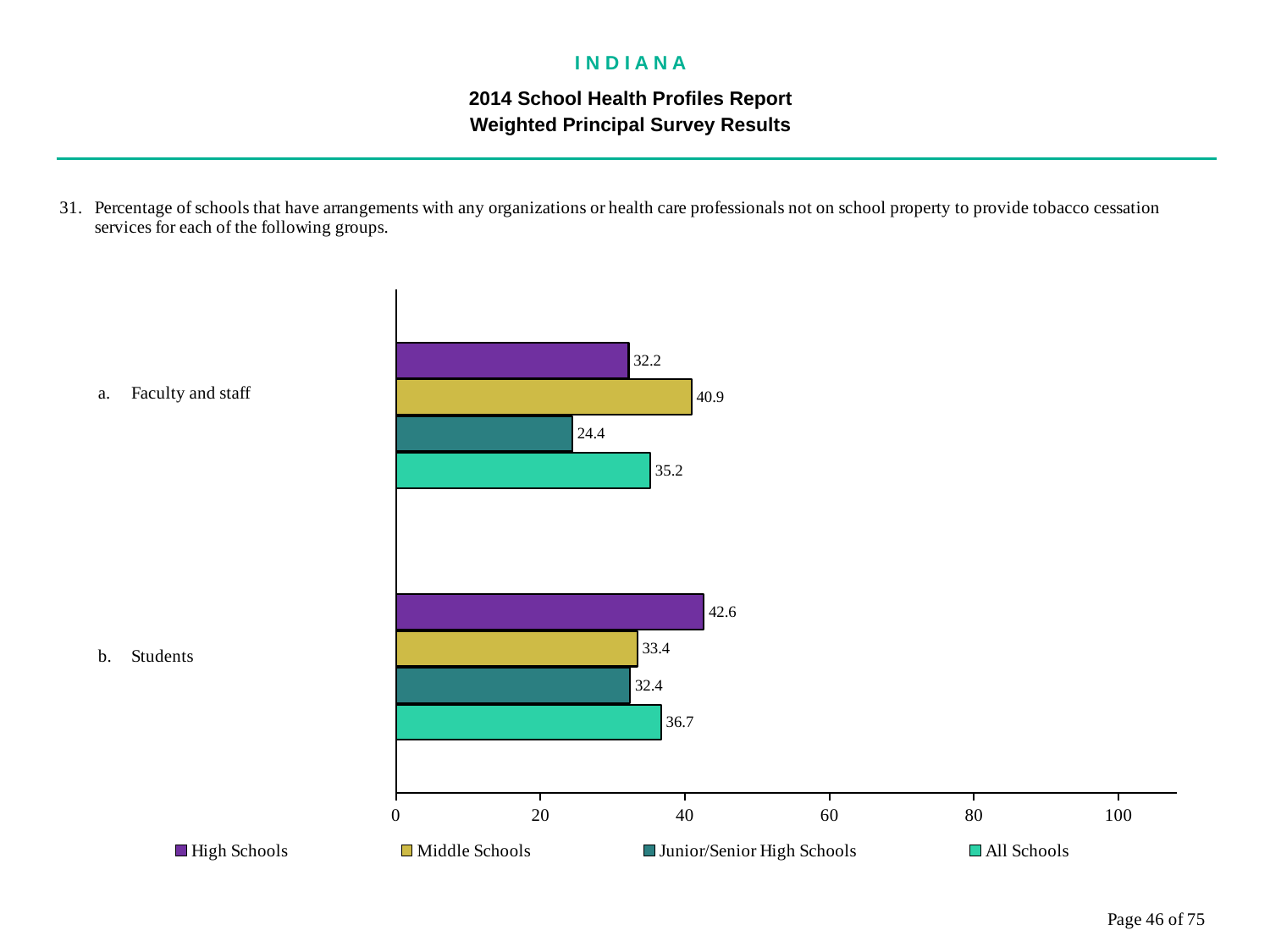
What is the difference between the Middle Schools and Junior/Senior High Schools values in the Faculty and staff category? 16.5 What is the value for High Schools in the Students category? 42.6 Which series has the highest value in the Faculty and staff category? Middle Schools How many series does the legend list? 4 Which is larger: the High Schools value for Faculty and staff or the High Schools value for Students? Students How many categories are shown on the chart? 2 What is the value for Middle Schools in the Faculty and staff category? 40.9 Which series has the lowest value in the Students category? Junior/Senior High Schools Is the value for Middle Schools in the Faculty and staff category greater or less than 40? greater What is the value for All Schools in the Students category? 36.7 What kind of chart is shown on the slide? Bar chart What is the value for Junior/Senior High Schools in the Faculty and staff category? 24.4